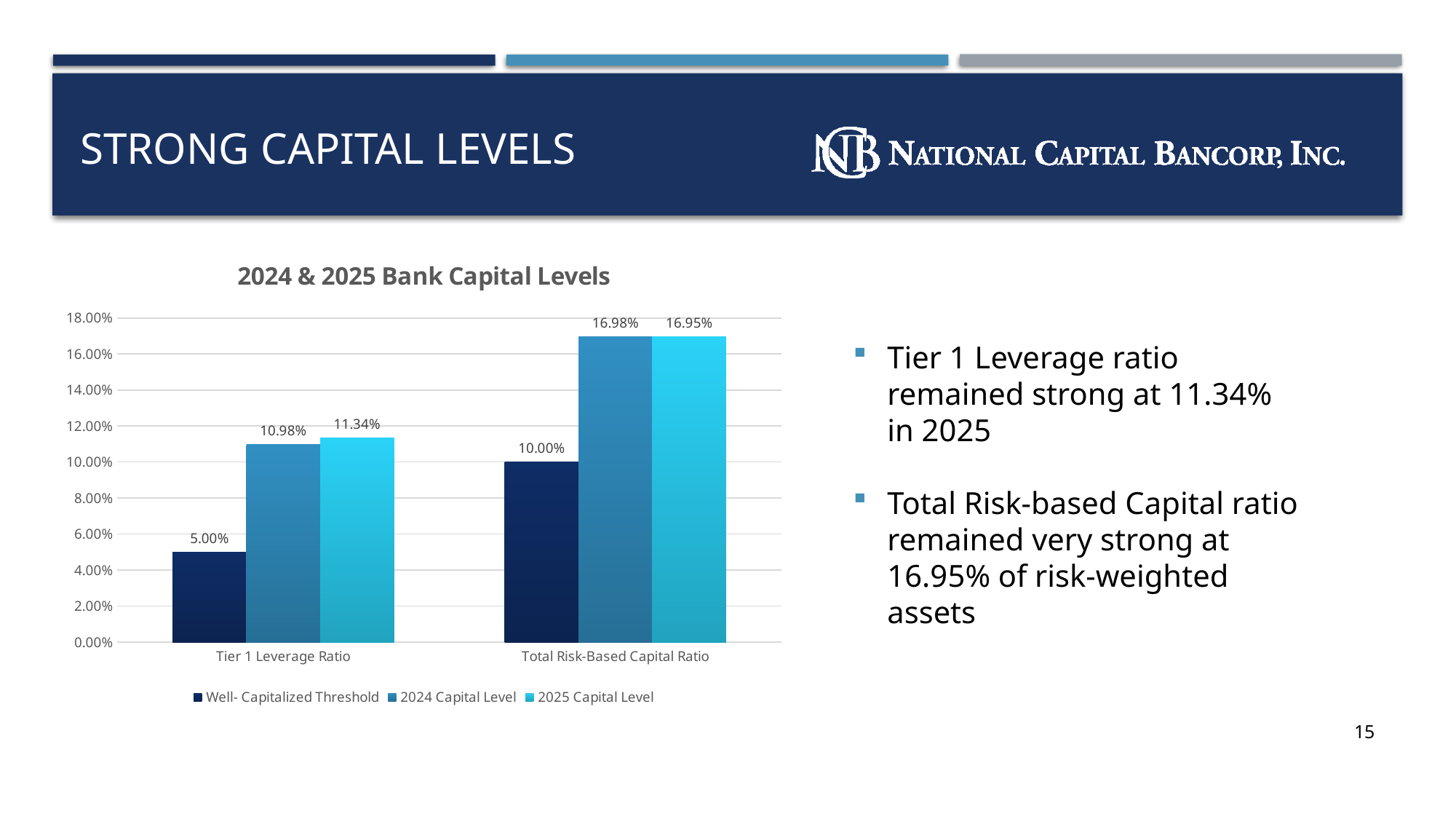
Which is larger for the Total Risk-Based Capital Ratio: the 2024 Capital Level or the Well-Capitalized Threshold? 2024 Capital Level What is the 2024 Capital Level for the Total Risk-Based Capital Ratio? 16.98% What kind of chart is shown on the slide? Bar chart What is the difference between the 2024 Capital Level and the 2025 Capital Level for the Tier 1 Leverage Ratio? 0.36% Which series has the lowest value for the Tier 1 Leverage Ratio? Well- Capitalized Threshold What is the title of the chart? 2024 & 2025 Bank Capital Levels How many series does the chart legend list? 3 What is the difference between the 2025 Capital Level and the Well-Capitalized Threshold for the Tier 1 Leverage Ratio? 6.34% What is the Well-Capitalized Threshold for the Tier 1 Leverage Ratio? 5.00% What is the Well-Capitalized Threshold for the Total Risk-Based Capital Ratio? 10.00% What is the 2025 Capital Level for the Tier 1 Leverage Ratio? 11.34% How many categories are shown on the x axis of the chart? 2